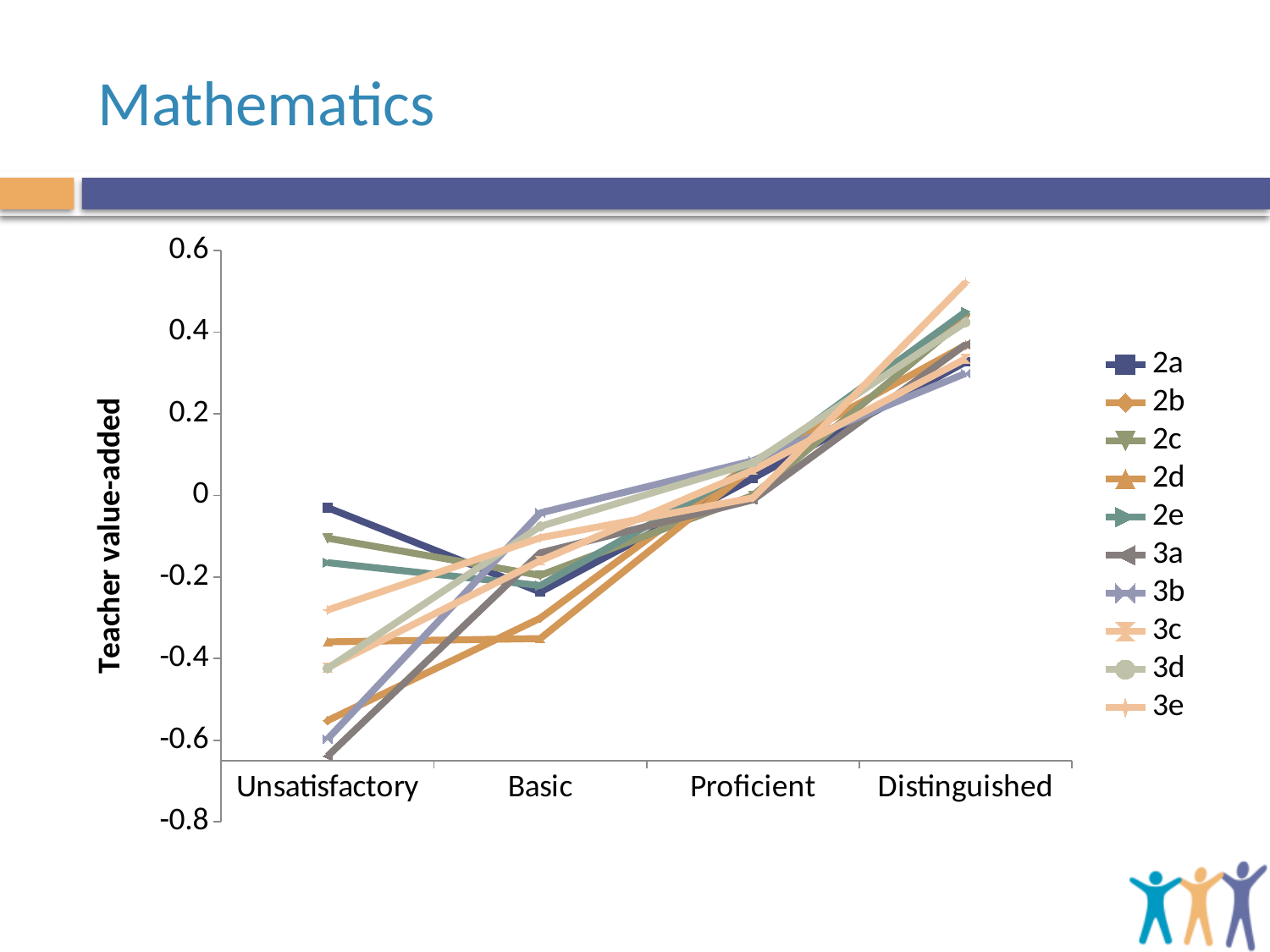
What kind of chart is shown on the slide? line chart What is the title of the y axis? Teacher value-added How many categories are shown on the x axis? 4 At Distinguished, which is larger: the value for 3e or the value for 3b? 3e Is the value for 2a at Unsatisfactory greater or less than -0.2? greater How many series does the legend list? 10 Is the value for 3b at Unsatisfactory greater or less than -0.4? less What is the title of the slide? Mathematics Which series has the highest value at Distinguished? 3e Is the value for 3e at Distinguished greater or less than 0.4? greater Does the value for 3e rise or fall from Unsatisfactory to Distinguished? rise Which series has the highest value at Unsatisfactory? 2a